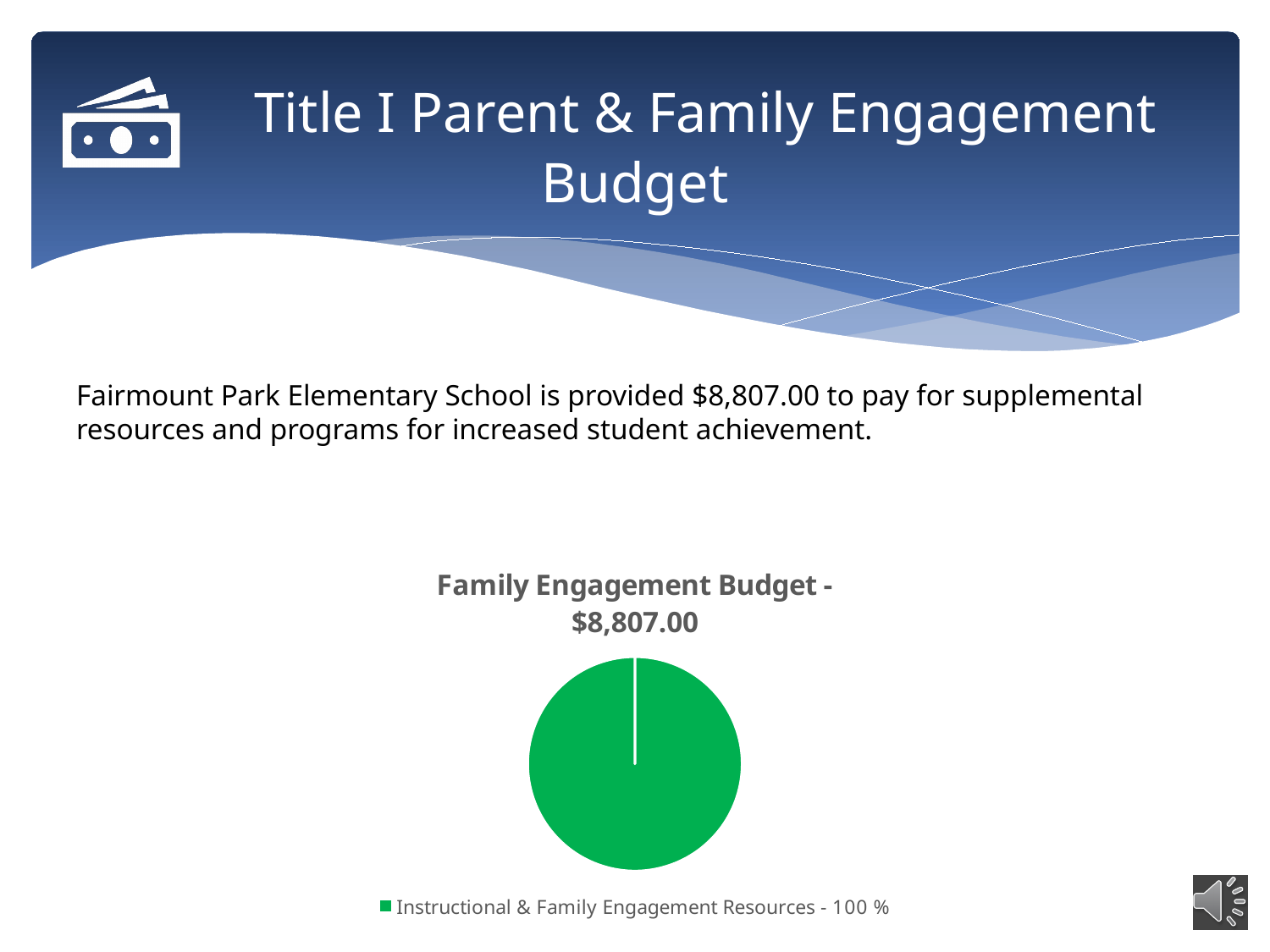
What share of the pie does Instructional & Family Engagement Resources represent? 100 % What is the label of the only legend entry in the chart? Instructional & Family Engagement Resources - 100 % What is the title of the chart? Family Engagement Budget - $8,807.00 How many slices does the pie chart have? 1 Which category makes up the largest share of the pie chart? Instructional & Family Engagement Resources What total budget amount is shown in the chart title? $8,807.00 What kind of chart is shown on the slide? Pie chart How many entries does the chart's legend list? 1